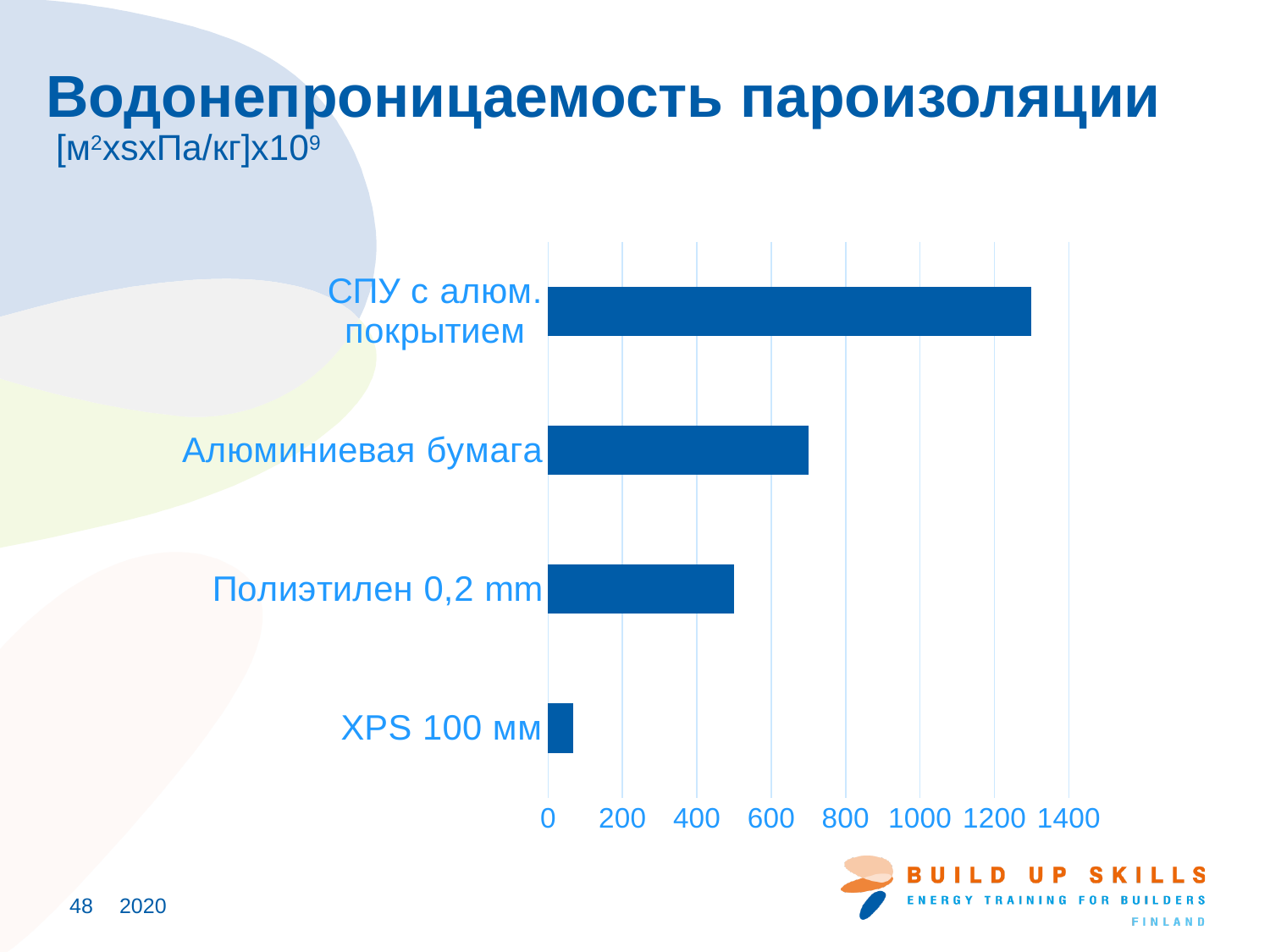
What is the highest value shown on the horizontal axis? 1400 Is the value for Алюминиевая бумага greater or less than 800? less Is the value for Алюминиевая бумага greater or less than 600? greater Is the value for СПУ с алюм. покрытием greater or less than 1200? greater Which category has the lowest value? XPS 100 мм Which category has the highest value? СПУ с алюм. покрытием Which has a larger value, Алюминиевая бумага or Полиэтилен 0,2 mm? Алюминиевая бумага What kind of chart is shown on the slide? bar chart How many categories are plotted in the chart? 4 What is the title of the chart on the slide? Водонепроницаемость пароизоляции